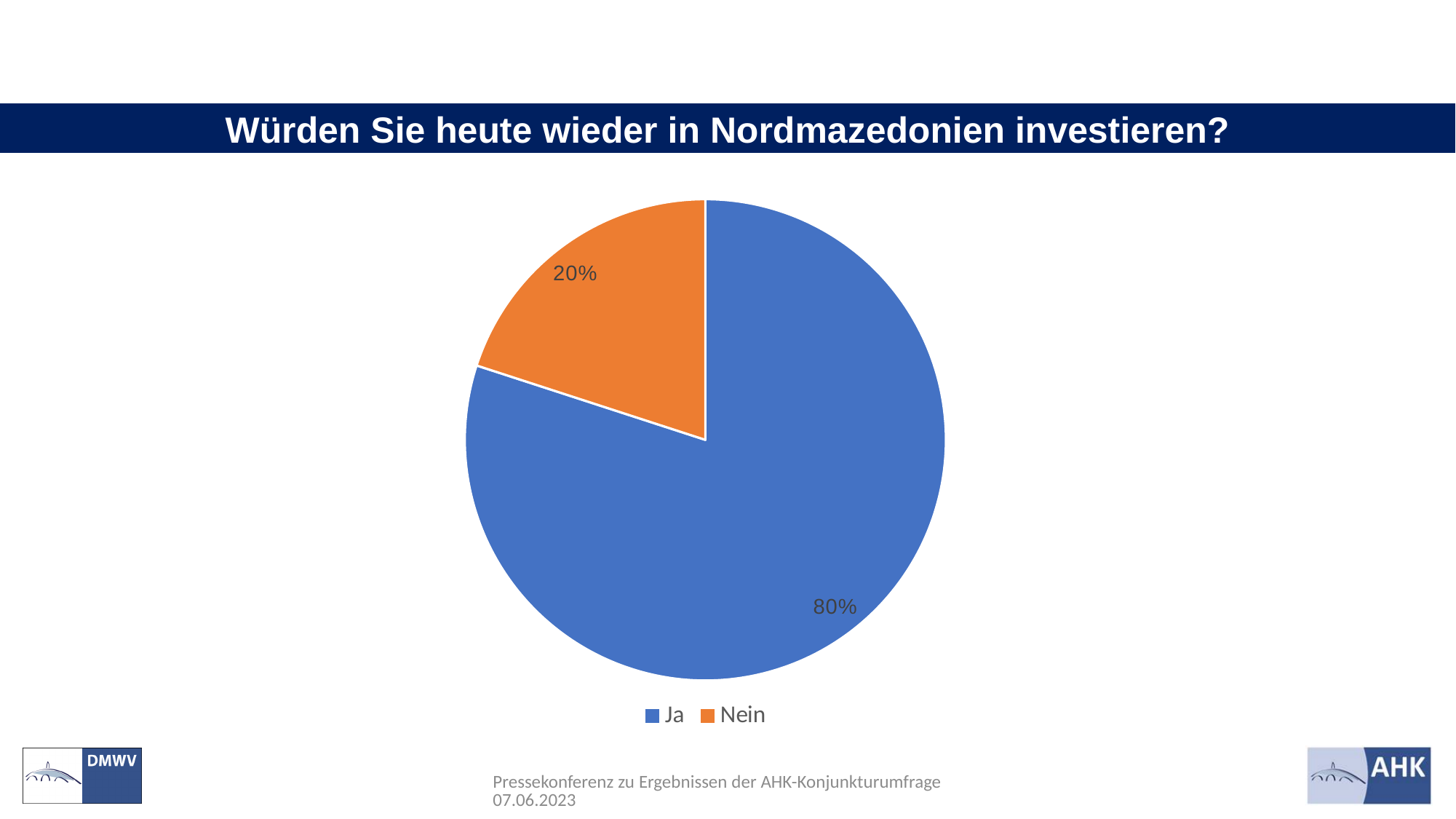
What colour is the "Nein" slice? orange Which category has the smallest slice of the pie? Nein What type of chart is shown on the slide? pie chart How many categories does the pie chart show? 2 What share of the pie does "Ja" represent? 80% Which is larger, the "Ja" slice or the "Nein" slice? Ja What is the title of the chart on the slide? Würden Sie heute wieder in Nordmazedonien investieren? How many entries does the legend list? 2 Which category has the largest slice of the pie? Ja What is the difference in percentage points between the "Ja" and "Nein" slices? 60 percentage points What share of the pie does "Nein" represent? 20%